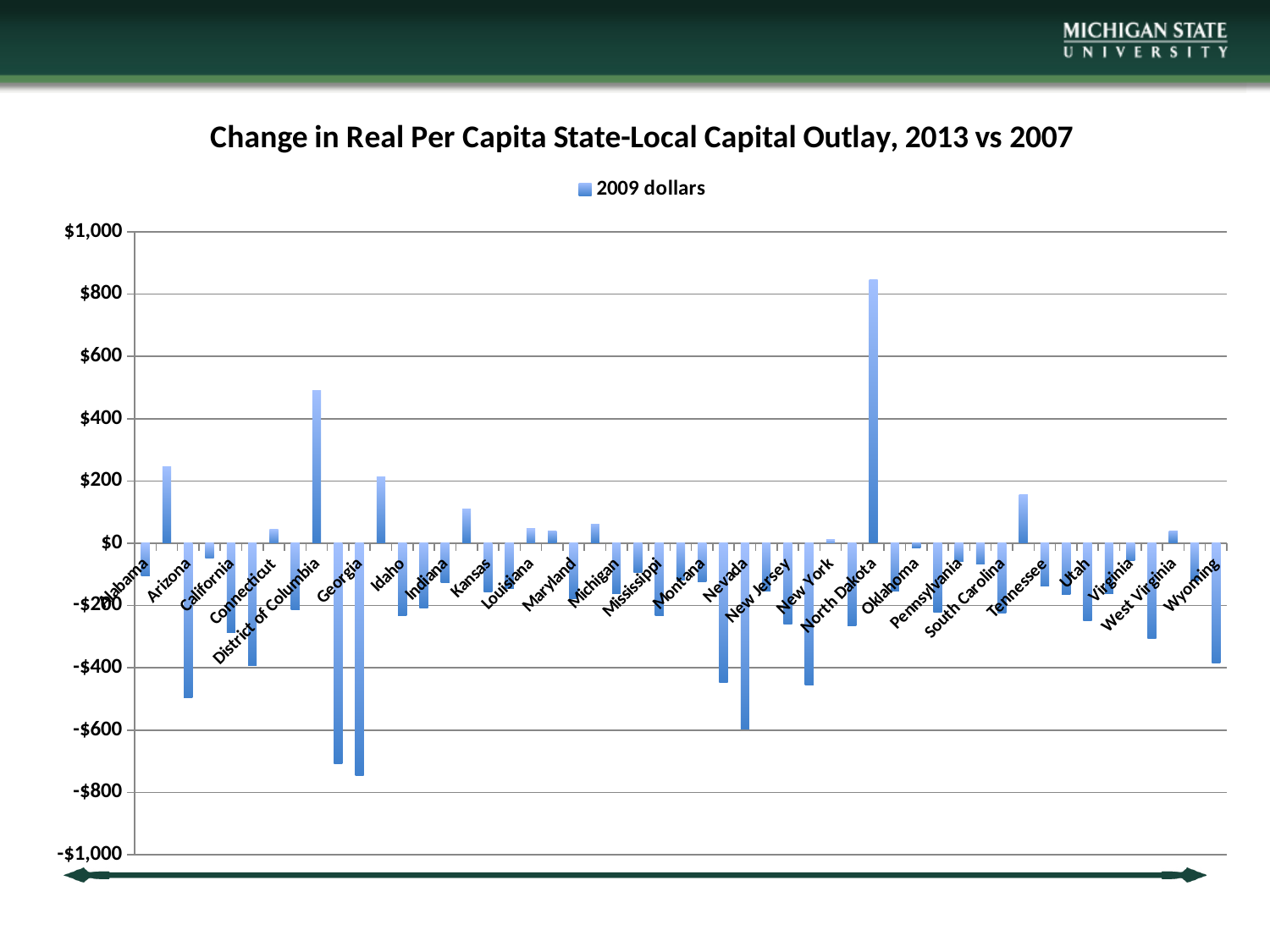
How many series does the legend list? 1 Is the value for District of Columbia greater or less than $400? greater What is the legend entry for the series in the chart? 2009 dollars Is the value for Nevada greater or less than -$400? less Is the value for North Dakota greater or less than $800? greater Which state has the highest change in real per capita state-local capital outlay? North Dakota Which has the larger value, North Dakota or District of Columbia? North Dakota Which has the larger value, Arizona or Nevada? Arizona What is the title of the chart? Change in Real Per Capita State-Local Capital Outlay, 2013 vs 2007 What kind of chart is shown on the slide? bar chart